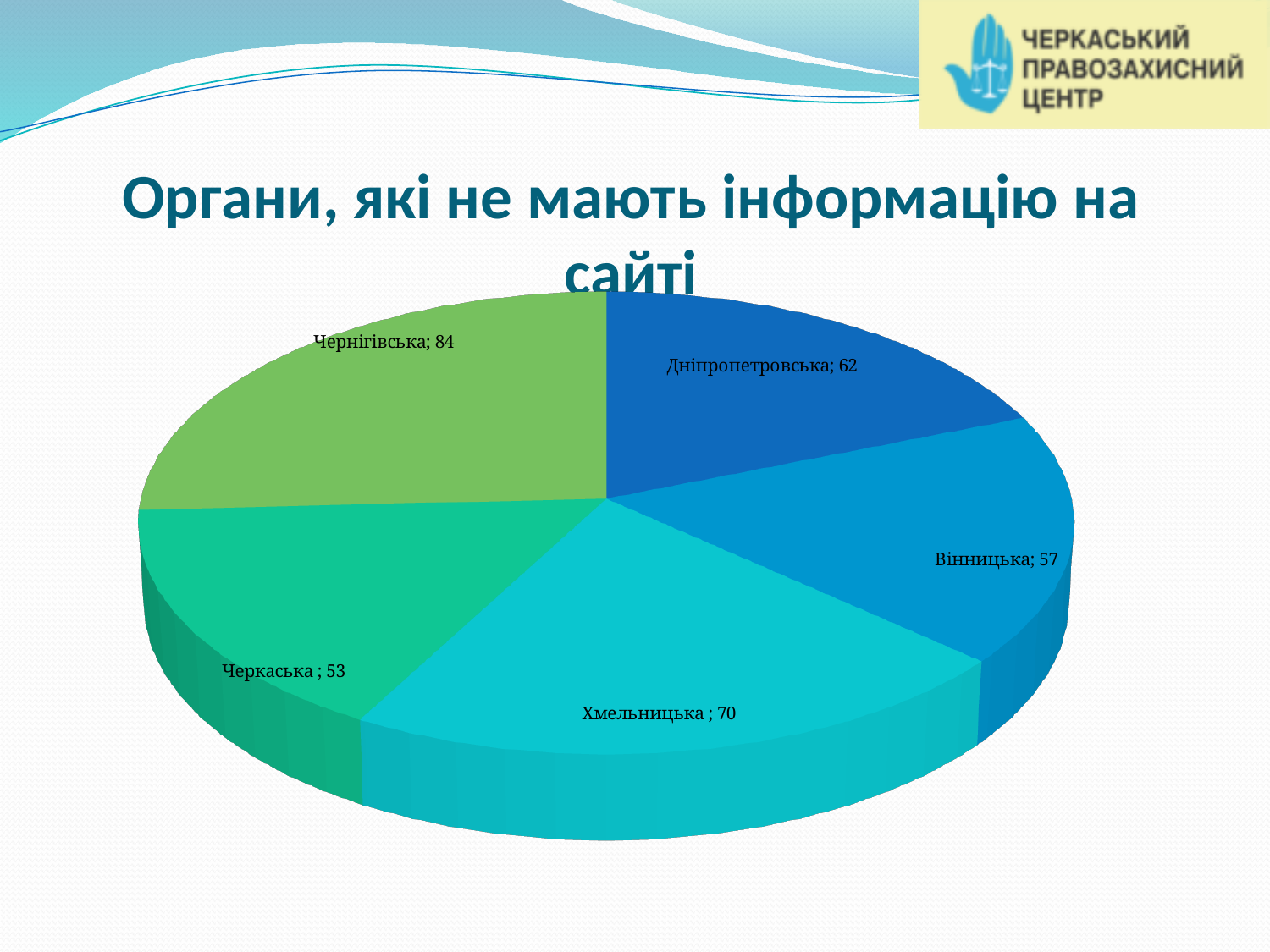
What is the value for Черкаська? 53 What is the value for Хмельницька? 70 What is the value for Вінницька? 57 How many slices does the pie chart have? 5 What is the title of the chart on the slide? Органи, які не мають інформацію на сайті What is the value for Чернігівська? 84 What is the difference between the values for Чернігівська and Черкаська? 31 Which region has the largest slice? Чернігівська Which is larger, the value for Дніпропетровська or the value for Вінницька? Дніпропетровська Which region has the smallest slice? Черкаська What is the difference between the values for Хмельницька and Дніпропетровська? 8 What kind of chart is shown on the slide? Pie chart